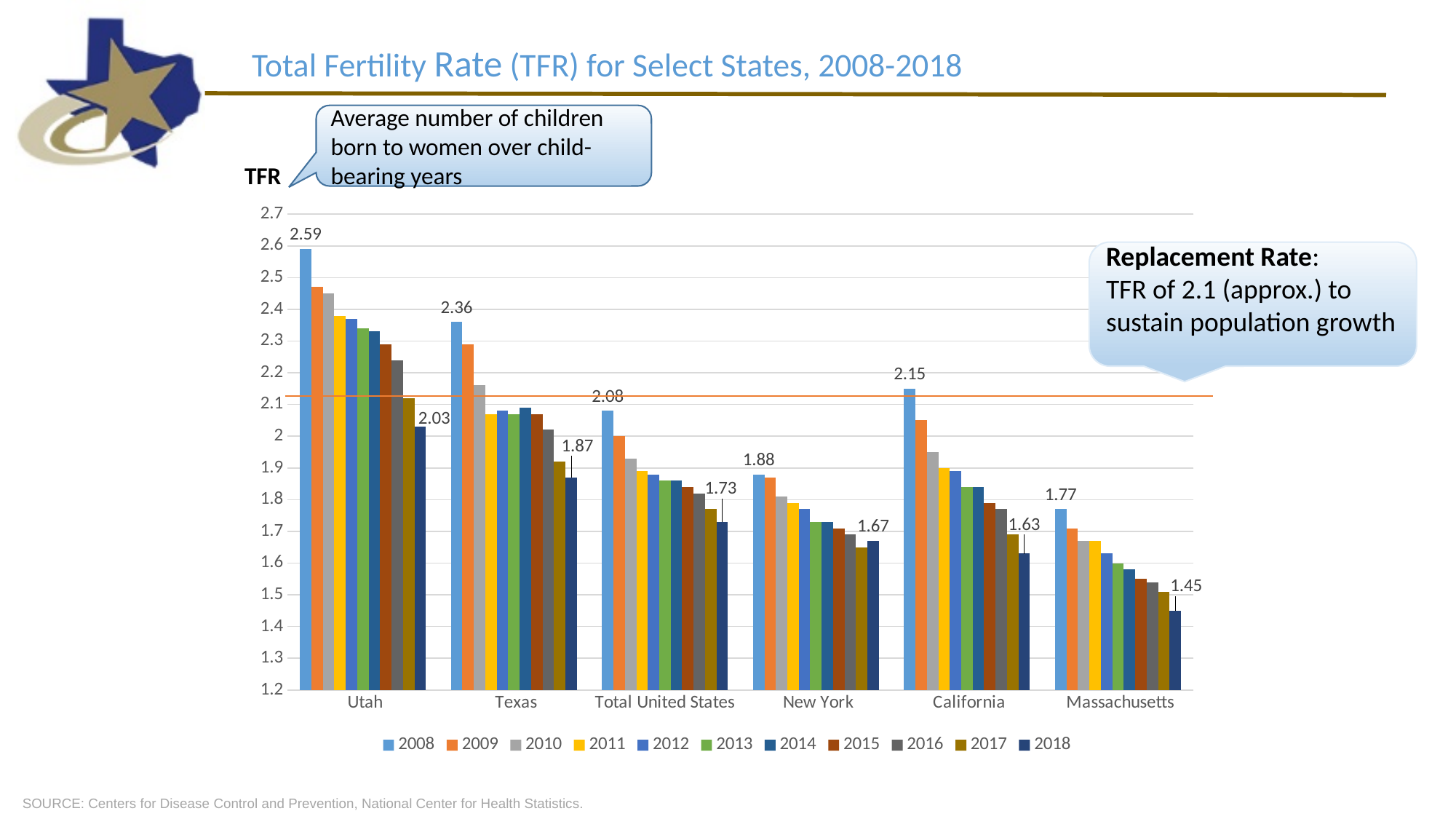
Which state had the highest TFR in 2008? Utah By how much did Utah's TFR fall from 2008 to 2018? 0.56 How many series does the legend list? 11 What was the TFR for Massachusetts in 2018? 1.45 What was Utah's TFR in 2008? 2.59 What is the difference between the 2018 TFR of Texas and the 2018 TFR of the Total United States? 0.14 Which was higher in 2018, the TFR of New York or the TFR of California? New York What was California's TFR in 2008? 2.15 What kind of chart is shown on the slide? Bar chart What was Texas's TFR in 2018? 1.87 Which state had the lowest TFR in 2018? Massachusetts Is the 2009 TFR for Texas greater or less than 2.2? greater